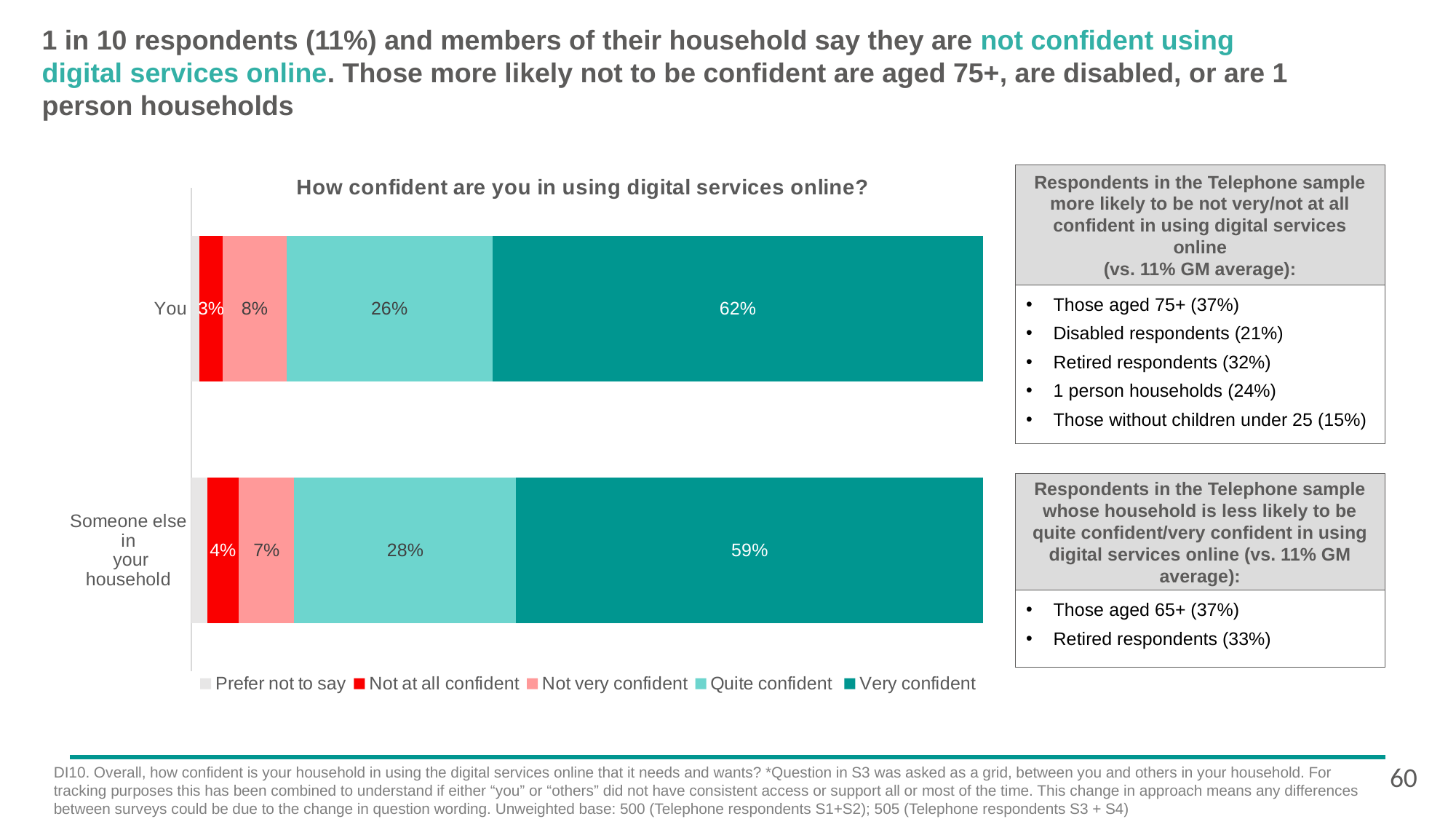
Which response category has the largest share for 'You'? Very confident What is the title of the chart? How confident are you in using digital services online? How many series does the legend list? 5 What percentage is shown for 'Quite confident' for 'Someone else in your household'? 28% Which labelled response category has the smallest share for 'You'? Not at all confident Which is larger: 'Quite confident' for 'You' or 'Quite confident' for 'Someone else in your household'? Someone else in your household What percentage is shown for 'Not at all confident' for 'Someone else in your household'? 4% How many categories (bars) are shown in the chart? 2 What is the difference between the 'Very confident' percentages for 'You' and 'Someone else in your household'? 3 percentage points What percentage of respondents say they are 'Very confident' for 'You'? 62% What type of chart is shown on the slide? Stacked bar chart What percentage is shown for 'Not very confident' for 'You'? 8%